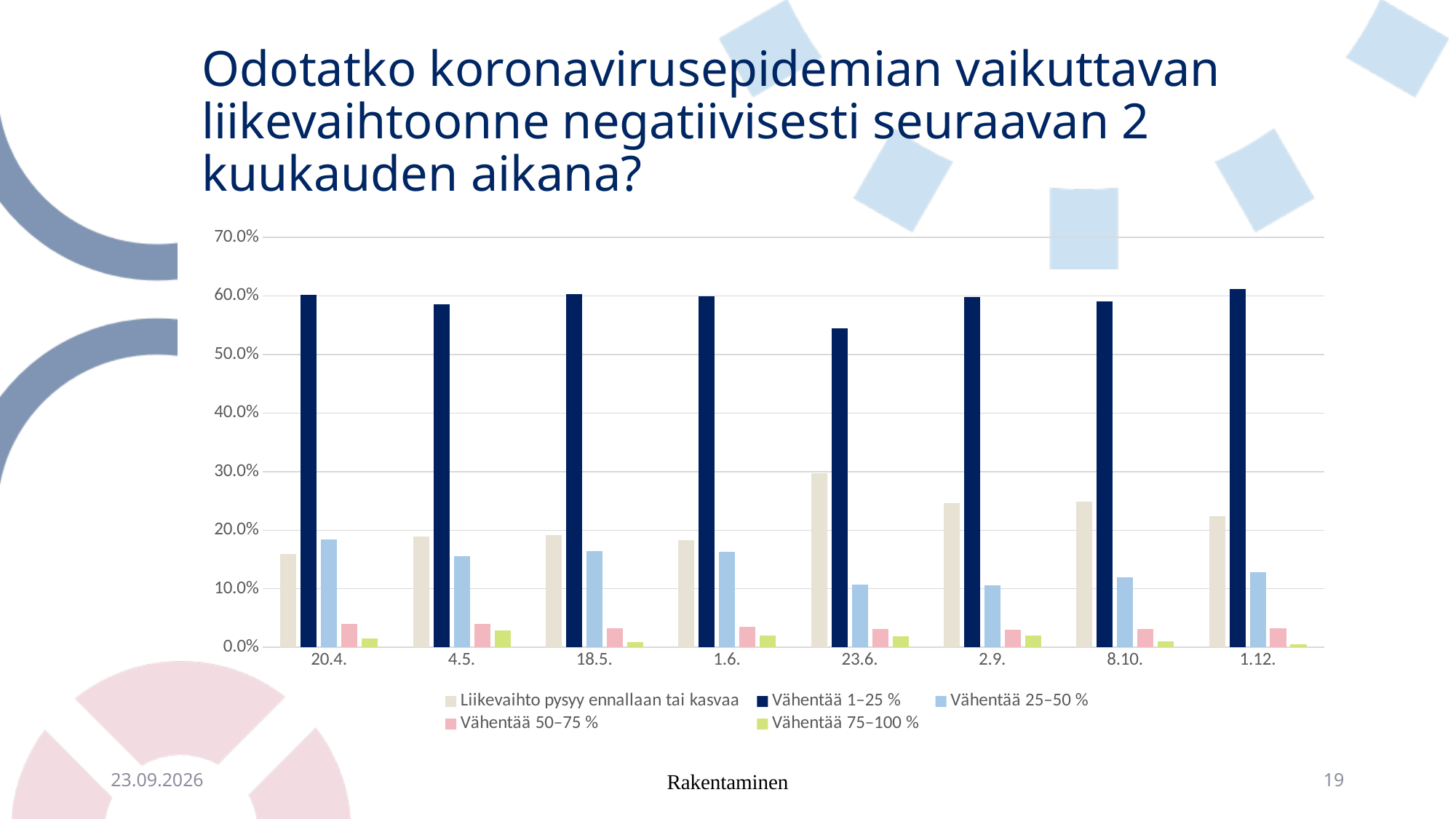
How many dates (categories) are shown on the x axis of the chart? 8 On 23.6., which is larger: 'Liikevaihto pysyy ennallaan tai kasvaa' or 'Vähentää 25–50 %'? Liikevaihto pysyy ennallaan tai kasvaa How many series does the chart's legend list? 5 What kind of chart is shown on the slide? bar chart Which series is drawn in dark blue in the chart? Vähentää 1–25 % Is the value for 'Vähentää 1–25 %' on 23.6. greater or less than 60.0%? less For which date is the 'Vähentää 25–50 %' bar the highest? 20.4. Is the value for 'Liikevaihto pysyy ennallaan tai kasvaa' on 23.6. greater or less than 20.0%? greater For which date is the 'Liikevaihto pysyy ennallaan tai kasvaa' bar the highest? 23.6. For which date is the 'Vähentää 1–25 %' bar the lowest? 23.6. Is the value for 'Vähentää 25–50 %' on 20.4. greater or less than 10.0%? greater